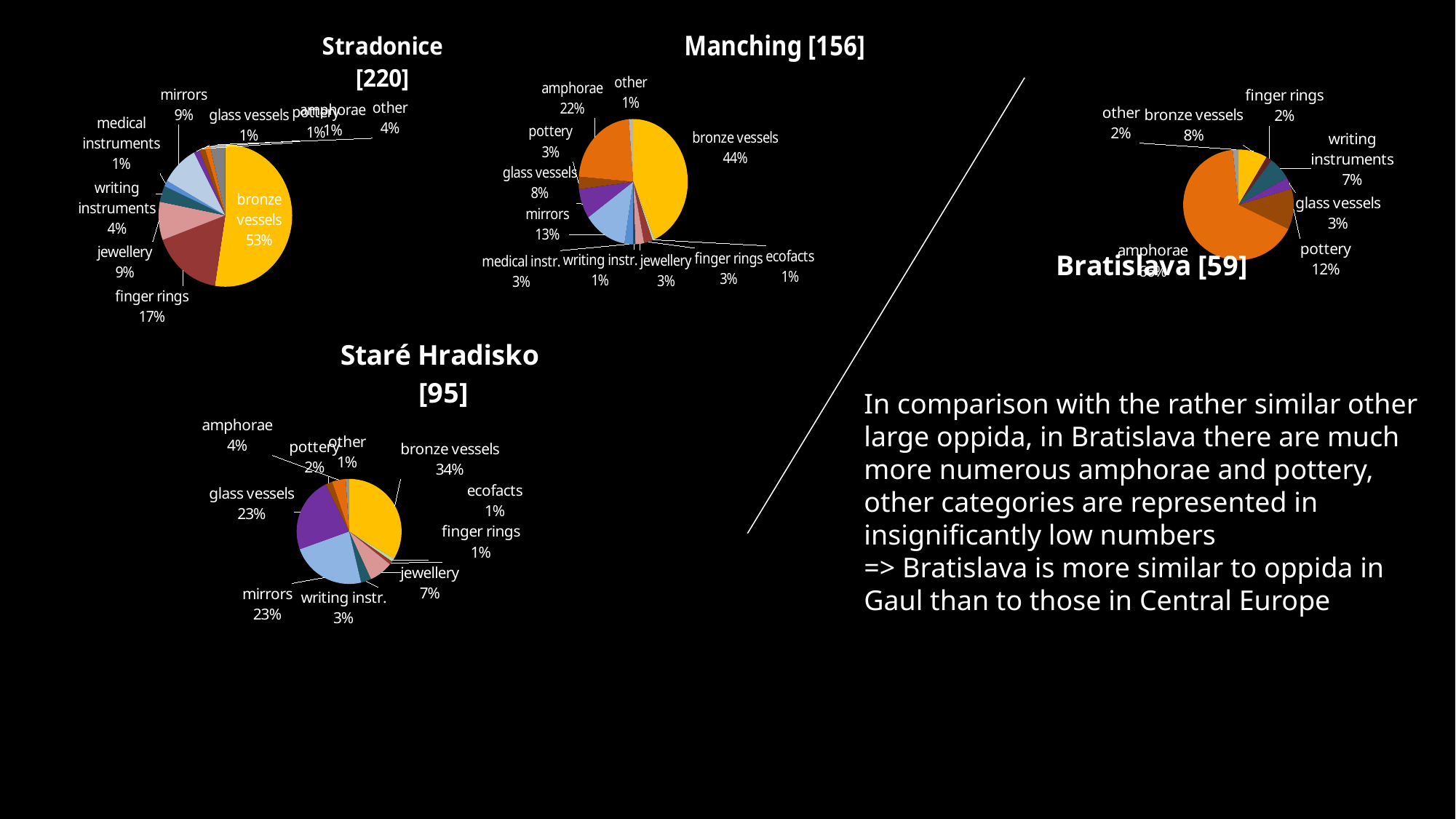
In the Staré Hradisko [95] pie chart, what is the percentage for glass vessels? 23% In the Manching [156] pie chart, which category has the largest share? bronze vessels What type of chart is used for Stradonice [220]? pie chart How many categories are shown in the Manching [156] pie chart? 11 In the Staré Hradisko [95] pie chart, which is larger, the share of bronze vessels or the share of jewellery? bronze vessels In the Manching [156] pie chart, what is the difference between the shares of bronze vessels and mirrors? 31% In the Bratislava [59] pie chart, what is the percentage for writing instruments? 7% In the Bratislava [59] pie chart, what is the percentage for pottery? 12% In the Stradonice [220] pie chart, what is the percentage for finger rings? 17% In the Manching [156] pie chart, what is the percentage for amphorae? 22% In the Stradonice [220] pie chart, what share do bronze vessels have? 53% How many pie charts are shown on the slide? 4